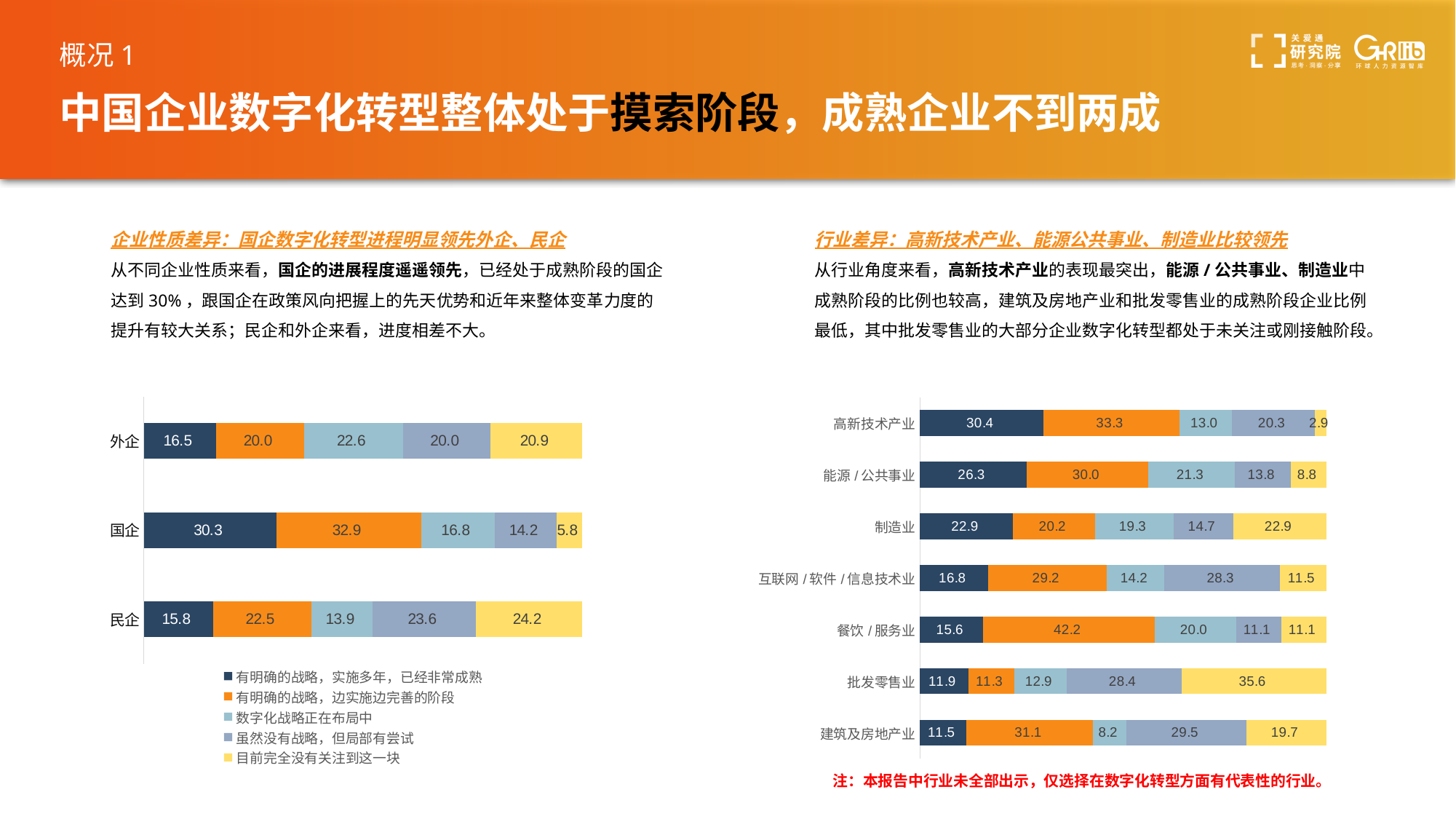
What kind of chart is the left chart (by enterprise type)? Stacked bar chart In the left chart (by enterprise type), which enterprise type has the lowest value for the yellow segment (目前完全没有关注到这一块)? 国企 In the right chart (by industry), is the dark blue segment value for 能源 / 公共事业 larger or smaller than that for 制造业? Larger In the right chart (by industry), which industry has the highest value for the dark blue segment (已经非常成熟)? 高新技术产业 In the left chart (by enterprise type), what is the value of the yellow segment (目前完全没有关注到这一块) for 民企? 24.2 In the left chart (by enterprise type), what is the difference between the dark blue segment values for 国企 and 外企? 13.8 In the right chart (by industry), how many industries are shown? 7 In the right chart (by industry), which industry has the highest value for the yellow segment (目前完全没有关注到这一块)? 批发零售业 In the left chart (by enterprise type), which enterprise type has the highest value for the dark blue segment (已经非常成熟)? 国企 In the left chart (by enterprise type), what is the value of the dark blue segment (有明确的战略，实施多年，已经非常成熟) for 国企? 30.3 In the left chart (by enterprise type), how many series does the legend list? 5 In the right chart (by industry), what is the value of the orange segment (边实施边完善的阶段) for 餐饮 / 服务业? 42.2